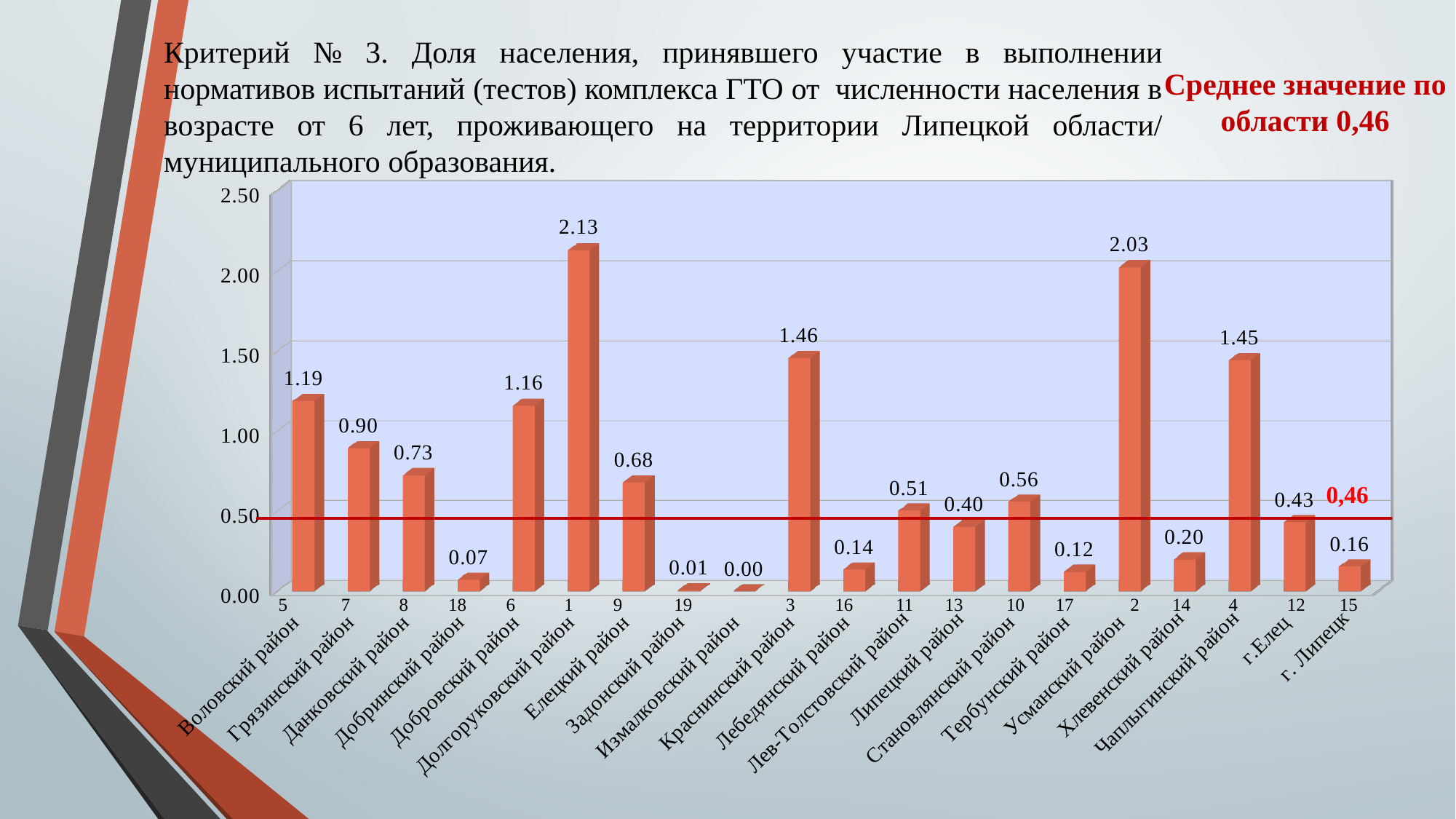
What is the value for Усманский район? 2.03 What is the difference between the values for Грязинский район and Данковский район? 0.17 What is the value for Долгоруковский район? 2.13 How many districts are shown on the chart? 20 Is the value for Воловский район greater or less than 1.00? greater What kind of chart is shown on the slide? bar chart What is the average value for the region shown by the horizontal red line? 0,46 What is the value for г. Липецк? 0.16 Which is larger, the value for Краснинский район or Чаплыгинский район? Краснинский район Which district has the highest value? Долгоруковский район What is the difference between the values for Долгоруковский район and Усманский район? 0.10 Which district has the lowest value? Измалковский район